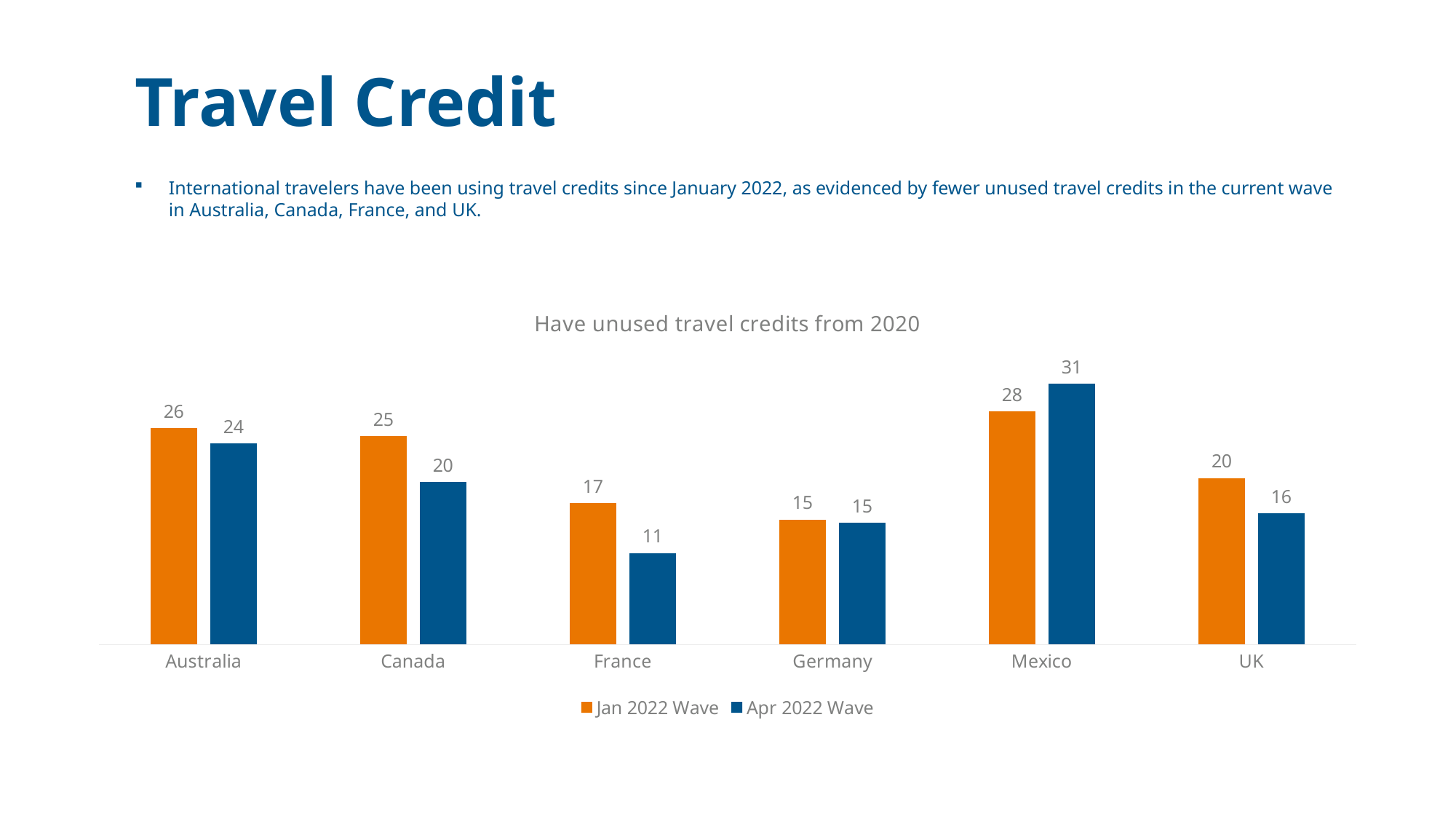
What is the difference between the Jan 2022 Wave and Apr 2022 Wave values for Canada? 5 Which is larger for the UK: the Jan 2022 Wave value or the Apr 2022 Wave value? Jan 2022 Wave How many countries are shown on the x axis? 6 What is the difference between the Jan 2022 Wave and Apr 2022 Wave values for France? 6 What is the Apr 2022 Wave value for Mexico? 31 What is the title of the chart? Have unused travel credits from 2020 What kind of chart is shown on the slide? Bar chart What is the Apr 2022 Wave value for France? 11 Which country has the highest Apr 2022 Wave value? Mexico How many series does the legend list? 2 What is the Jan 2022 Wave value for Australia? 26 Which country has the lowest Jan 2022 Wave value? Germany